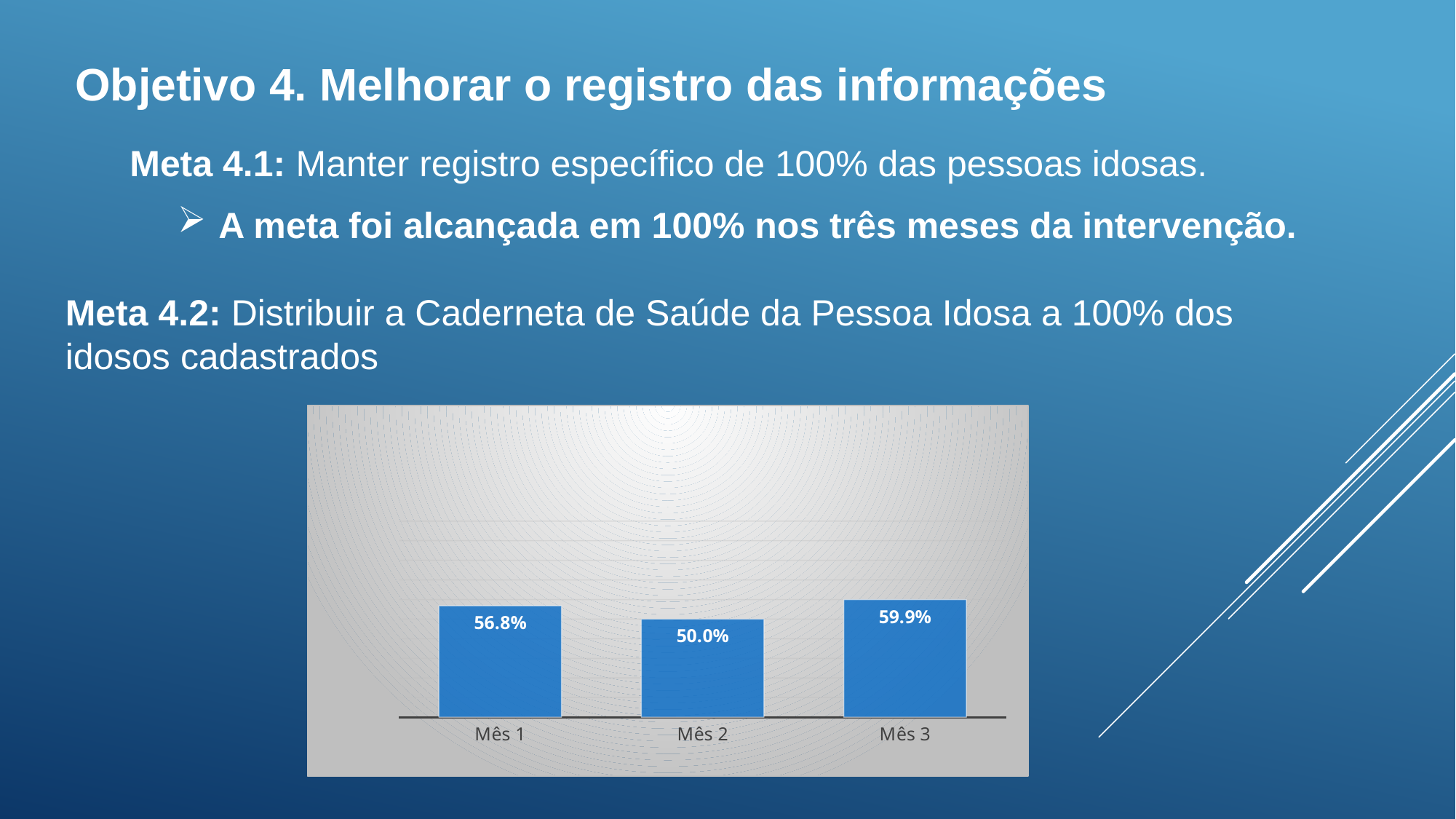
What is the difference between the values for Mês 1 and Mês 2? 6.8% How many categories are shown on the chart? 3 What is the value for Mês 1? 56.8% Does the value rise or fall from Mês 2 to Mês 3? Rise What is the value for Mês 2? 50.0% Which month has the highest value? Mês 3 What is the difference between the values for Mês 3 and Mês 1? 3.1% What kind of chart is shown on the slide? Bar chart What colour are the bars in the chart? Blue Which is larger, the value for Mês 1 or the value for Mês 2? Mês 1 What is the value for Mês 3? 59.9% Which month has the lowest value? Mês 2